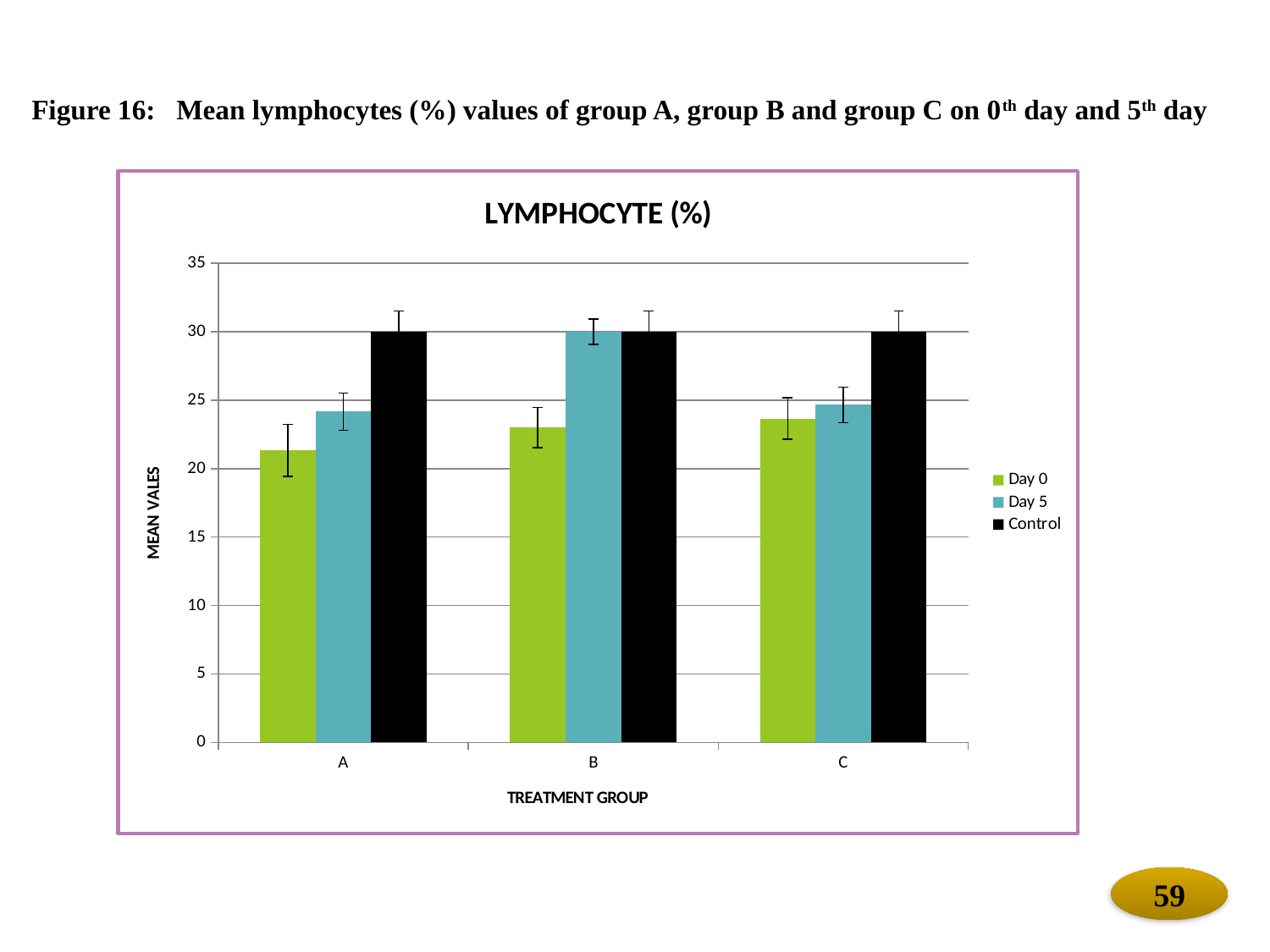
What is the Control value for treatment group A? 30 How many series does the legend list? 3 What kind of chart is shown on the slide? bar chart Is the Day 0 value for treatment group A greater or less than 25? less What is the title of the chart? LYMPHOCYTE (%) How many treatment groups are shown on the x axis? 3 For treatment group B, which is larger, the Day 0 value or the Day 5 value? Day 5 Is the Day 5 value for treatment group A greater or less than 25? less Is the Day 0 value for treatment group A greater or less than 20? greater Which treatment group has the highest Day 5 value? B Which treatment group has the lowest Day 0 value? A What is the Day 5 value for treatment group B? 30